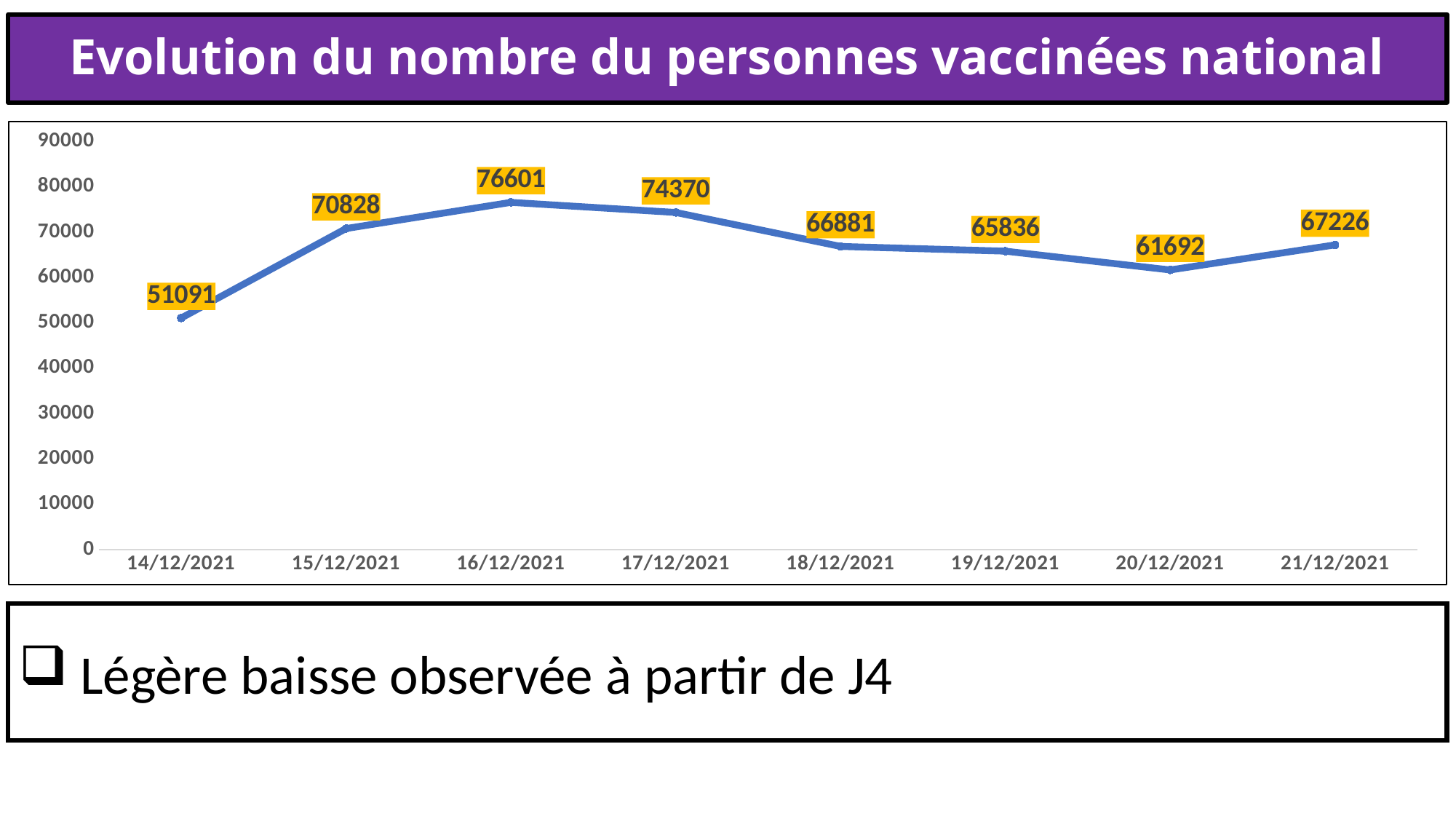
What is the difference between the values for 16/12/2021 and 17/12/2021? 2231 What is the title of the chart? Evolution du nombre du personnes vaccinées national Which is larger, the value for 18/12/2021 or the value for 21/12/2021? 21/12/2021 What kind of chart is shown on the slide? line chart How many dates are plotted on the chart? 8 What is the difference between the values for 15/12/2021 and 14/12/2021? 19737 Is the value for 19/12/2021 greater or less than 70000? less What is the value for 20/12/2021? 61692 Which date has the lowest value? 14/12/2021 Which date has the highest value? 16/12/2021 What is the value for 14/12/2021? 51091 What is the value for 16/12/2021? 76601